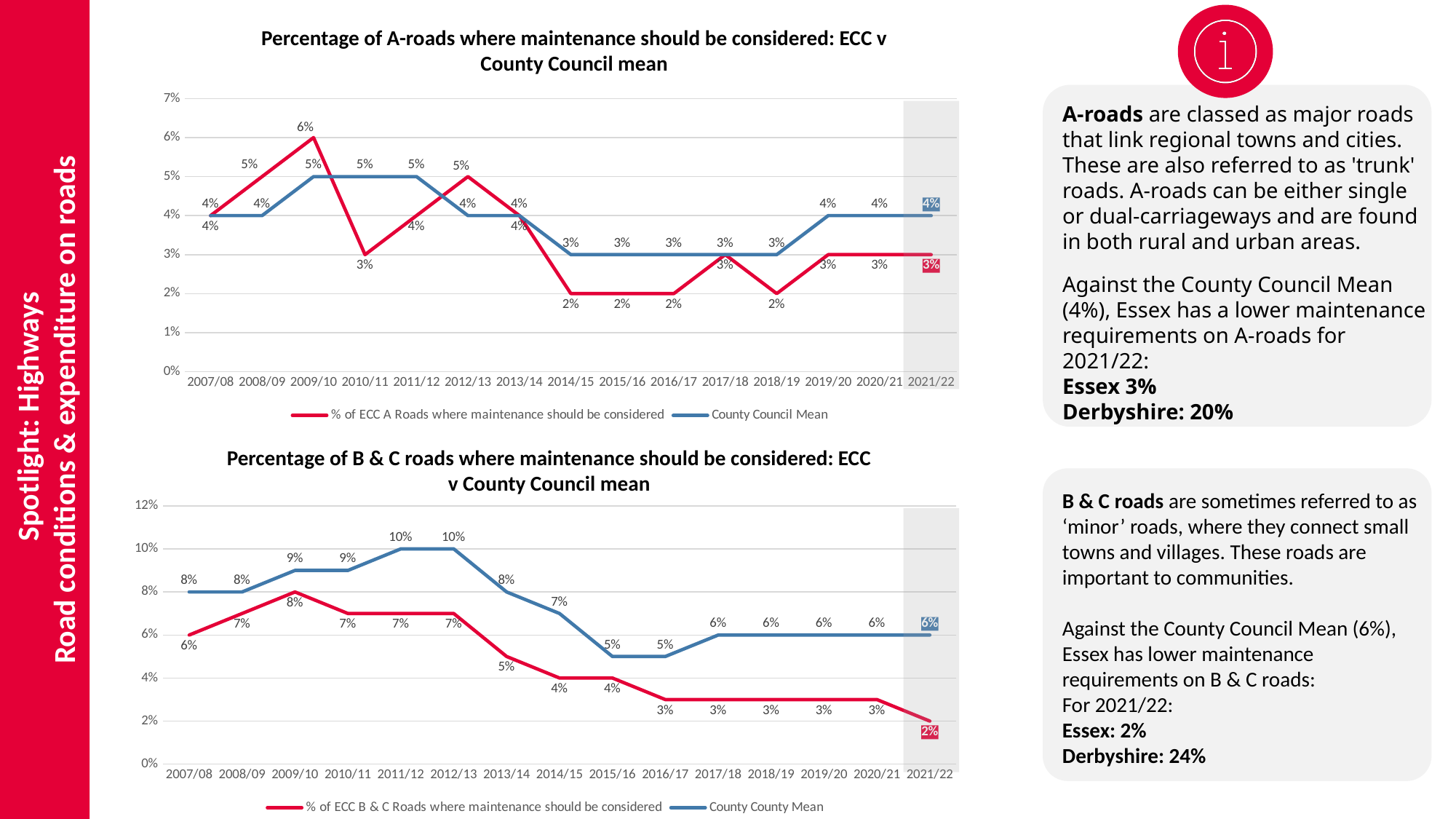
In the top chart (A-roads), in which year does the ECC A roads series reach its highest value? 2009/10 How many series does the legend of the top chart (A-roads) list? 2 In the top chart (A-roads), what is the County Council Mean in 2021/22? 4% In the bottom chart (B & C roads), what is the County Council Mean in 2011/12? 10% In the top chart (A-roads), what is the difference between the County Council Mean and the ECC value in 2021/22? 1% In the bottom chart (B & C roads), what is the ECC B & C roads value in 2021/22? 2% In the top chart (A-roads), what is the value for ECC A roads in 2009/10? 6% In the top chart (A-roads), which is larger in 2010/11: the ECC A roads value or the County Council Mean? County Council Mean In the bottom chart (B & C roads), what is the difference between the County Council Mean and the ECC value in 2021/22? 4% What type of chart is the bottom chart (B & C roads)? Line chart In the top chart (A-roads), how many years are shown on the x axis? 15 In the bottom chart (B & C roads), does the ECC B & C roads series generally rise or fall from 2012/13 to 2021/22? Fall